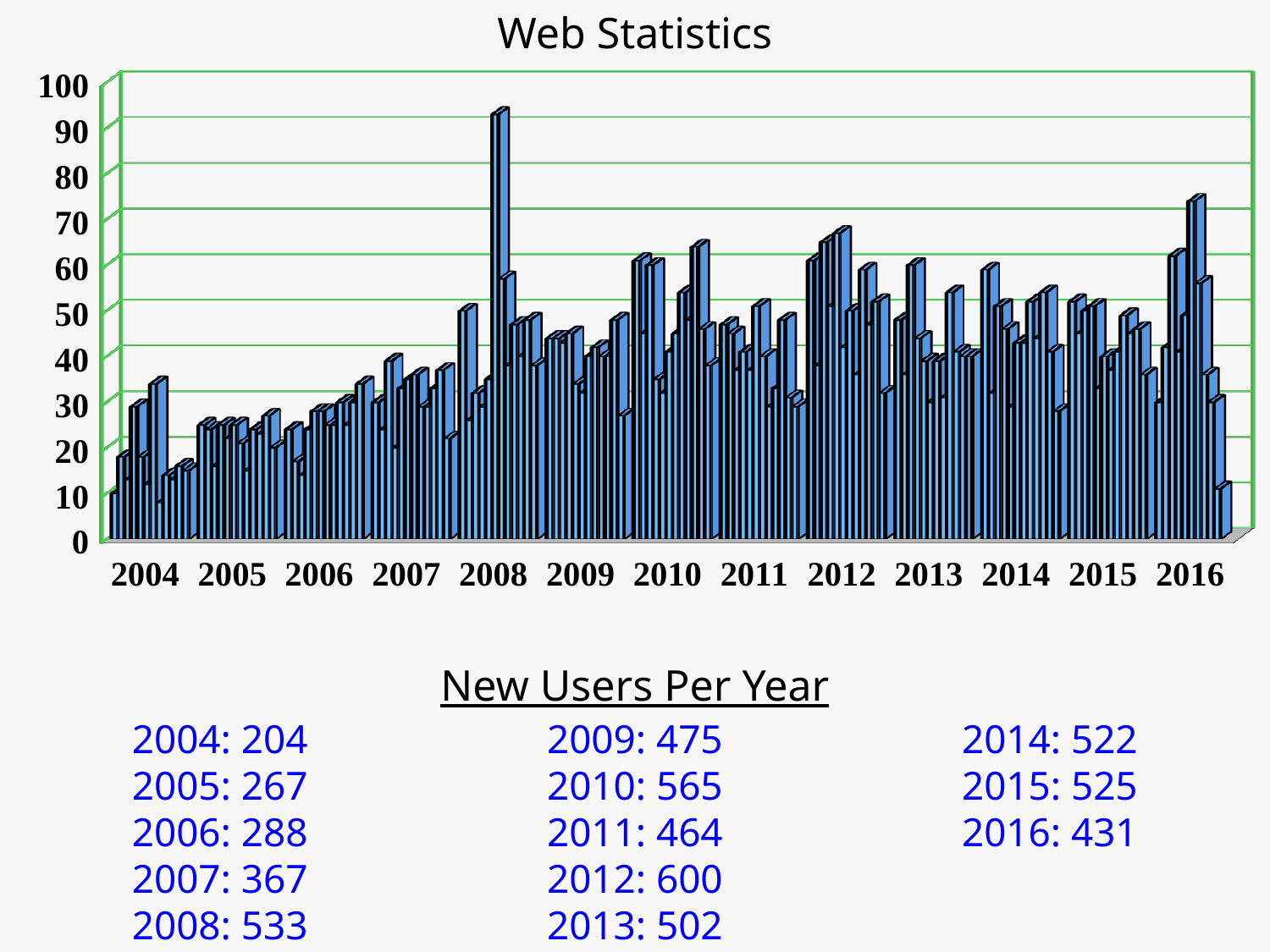
Is the tallest bar in 2012 greater or less than 60? greater Is the first bar of 2004 greater or less than 20? less Which year has the taller peak bar, 2008 or 2012? 2008 Overall, do the bars rise or fall from 2004 to 2012? rise What is the highest value shown on the y axis? 100 How many years are labeled along the x axis of the chart? 13 Is the tallest bar in 2008 greater or less than 90? greater What kind of chart is shown on the slide? bar chart In which year does the tallest bar of the chart appear? 2008 What is the title of the chart? Web Statistics